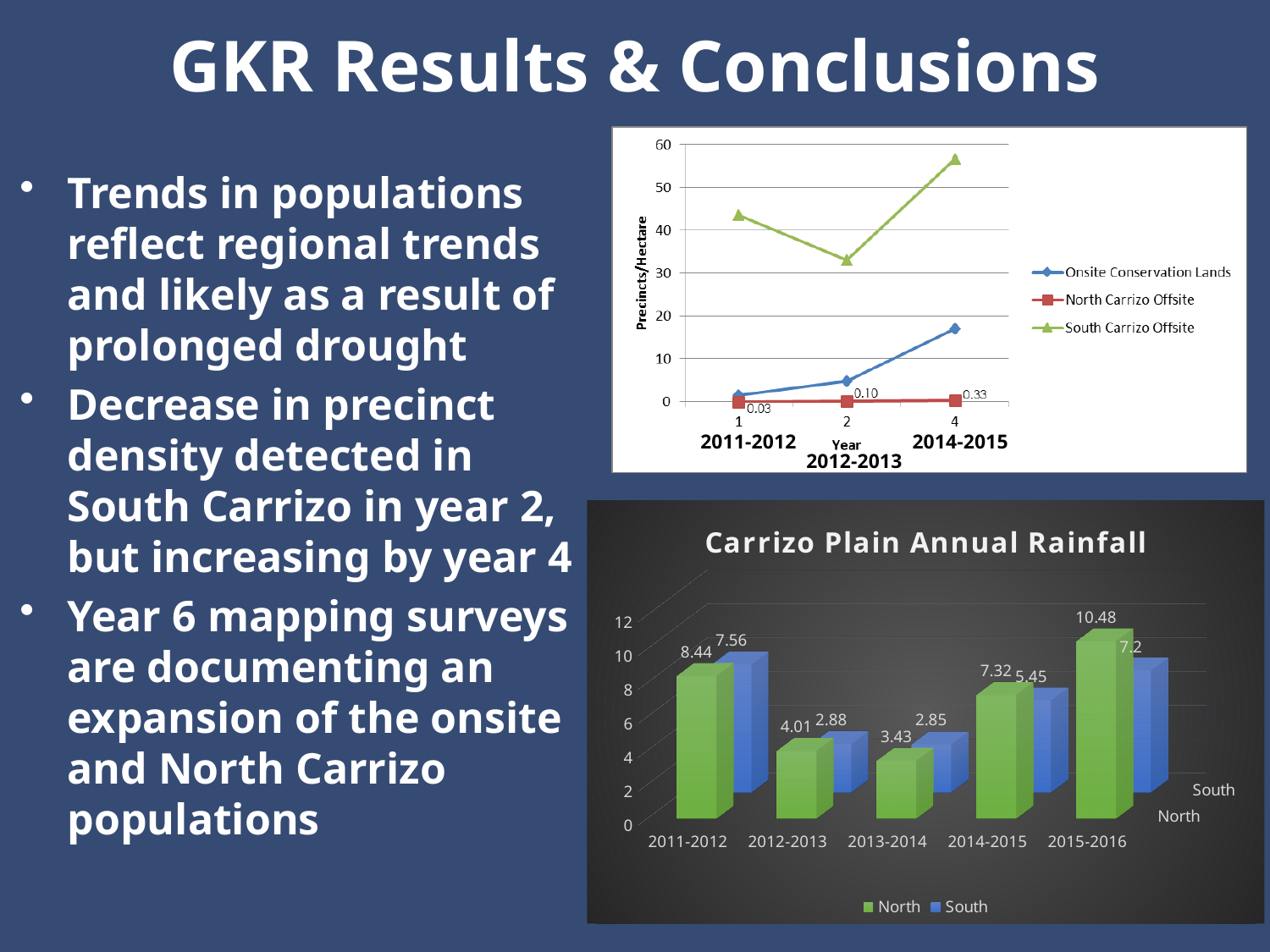
How many years are shown on the x axis of the Carrizo Plain Annual Rainfall chart? 5 In the top line chart, which series has the highest value at year 1? South Carrizo Offsite How many series does the legend of the Carrizo Plain Annual Rainfall chart list? 2 In the Carrizo Plain Annual Rainfall chart, what is the North value for 2015-2016? 10.48 In the top line chart, what is the North Carrizo Offsite value at year 4? 0.33 In the Carrizo Plain Annual Rainfall chart, what is the difference between the North and South values for 2015-2016? 3.28 What kind of chart is the top chart on the slide? line chart In the Carrizo Plain Annual Rainfall chart, is the North value for 2014-2015 larger or smaller than the South value for 2014-2015? larger In the Carrizo Plain Annual Rainfall chart, which year has the highest South value? 2011-2012 In the Carrizo Plain Annual Rainfall chart, what is the South value for 2011-2012? 7.56 In the top line chart, is the South Carrizo Offsite value at year 4 greater or less than 50? greater In the Carrizo Plain Annual Rainfall chart, which year has the lowest North value? 2013-2014